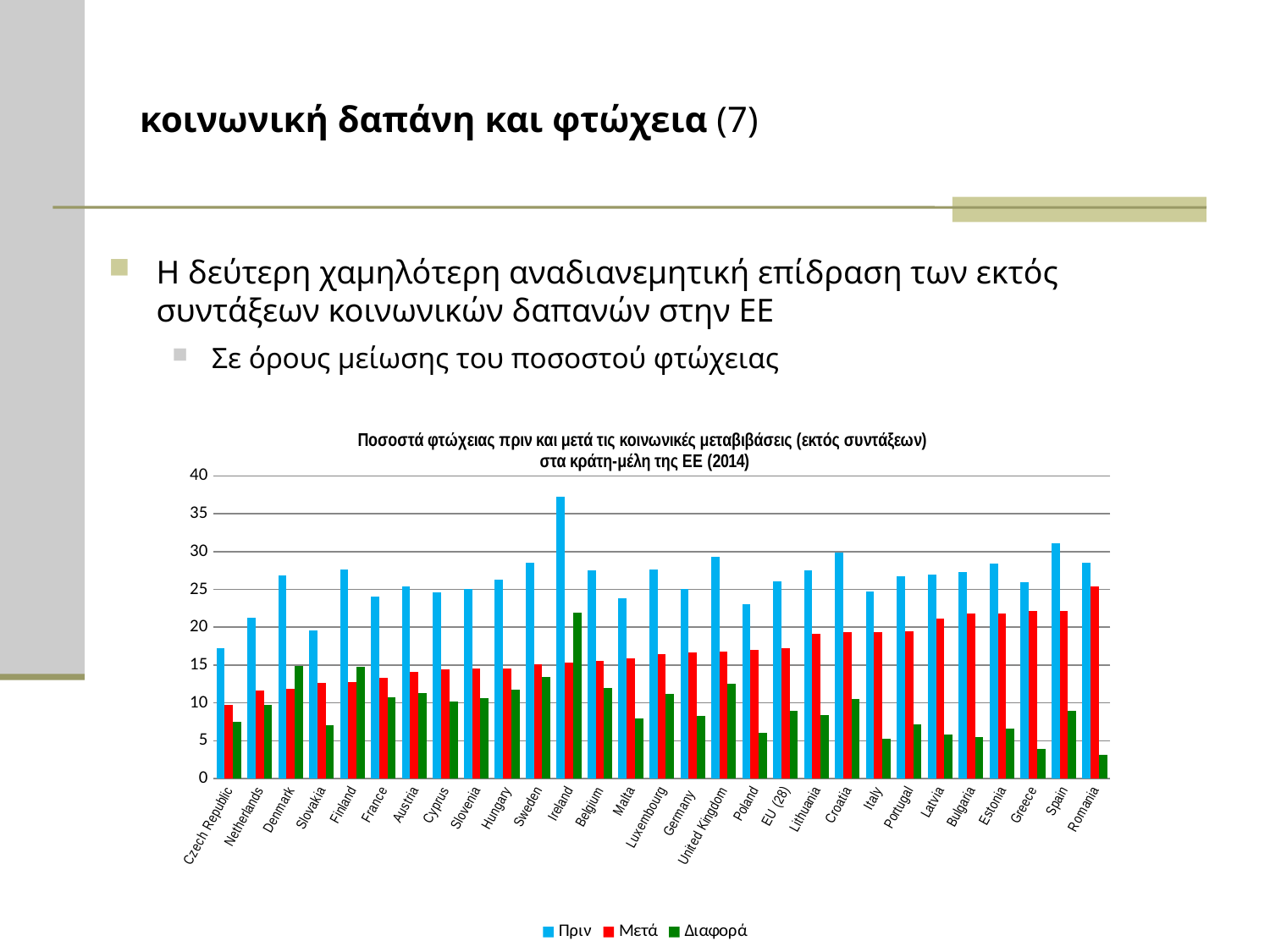
How many series does the legend list? 3 Which category has the highest value for the Πριν series? Ireland Which category has the highest value for the Μετά series? Romania What kind of chart is shown on the slide? bar chart Is the Πριν value for Ireland greater or less than 35? greater Do the values of the Μετά series rise or fall moving from left to right along the x axis? rise Which has the larger Πριν value, Spain or Greece? Spain How many countries/categories are shown on the x axis? 29 Which category has the lowest value for the Διαφορά series? Romania Is the Διαφορά value for Romania greater or less than 5? less Which category has the lowest value for the Μετά series? Czech Republic Is the Πριν value for Spain greater or less than 30? greater